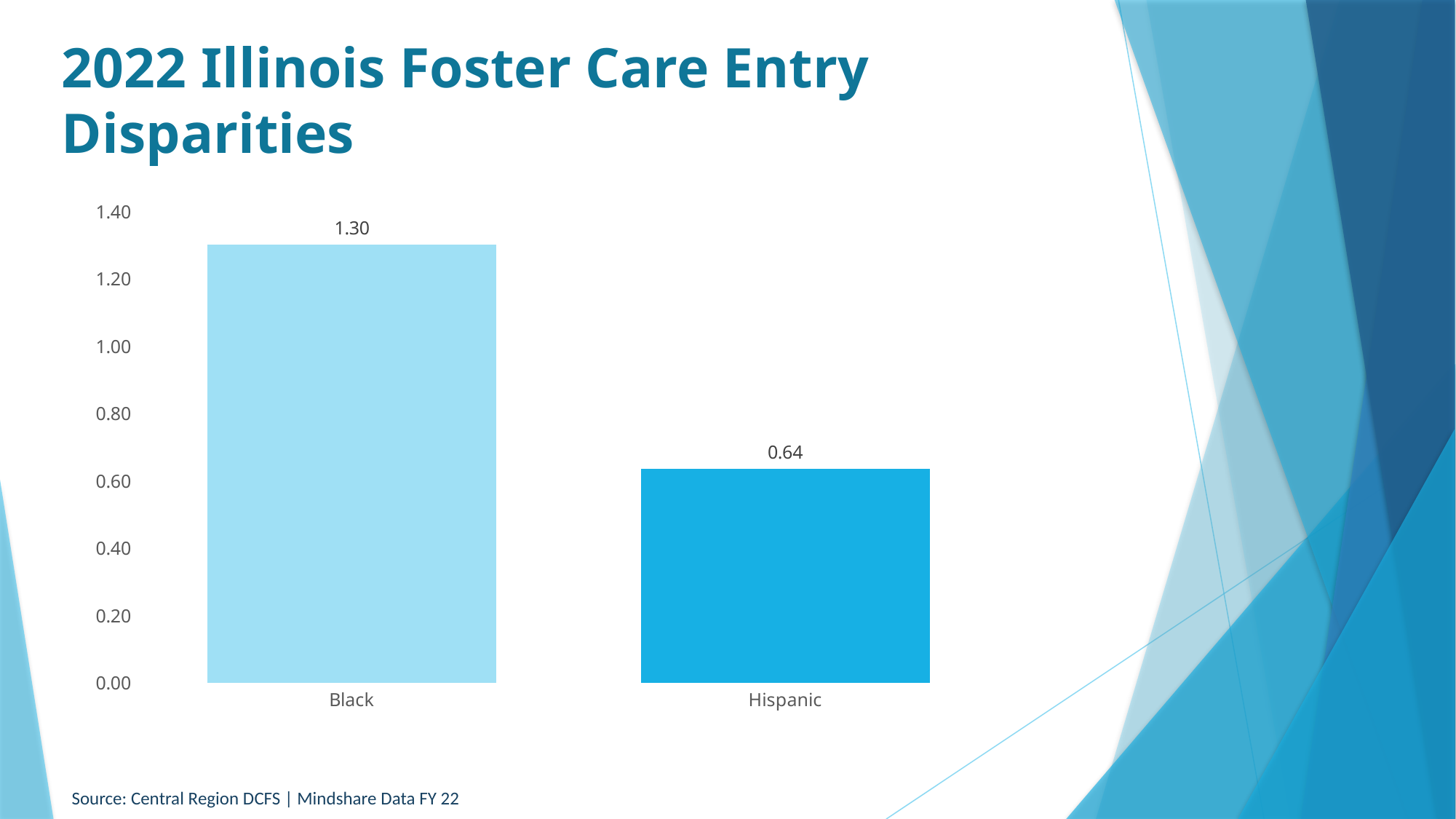
How many categories are shown in the chart? 2 What is the value for Black? 1.30 What is the title of the slide? 2022 Illinois Foster Care Entry Disparities What kind of chart is shown on the slide? bar chart Which category has the lowest value? Hispanic Which is larger, the value for Black or the value for Hispanic? Black What is the difference between the values for Black and Hispanic? 0.66 Is the value for Hispanic greater or less than 0.80? less Which category has the highest value? Black Is the value for Black greater or less than 1.00? greater What is the highest value shown on the vertical axis? 1.40 What is the value for Hispanic? 0.64